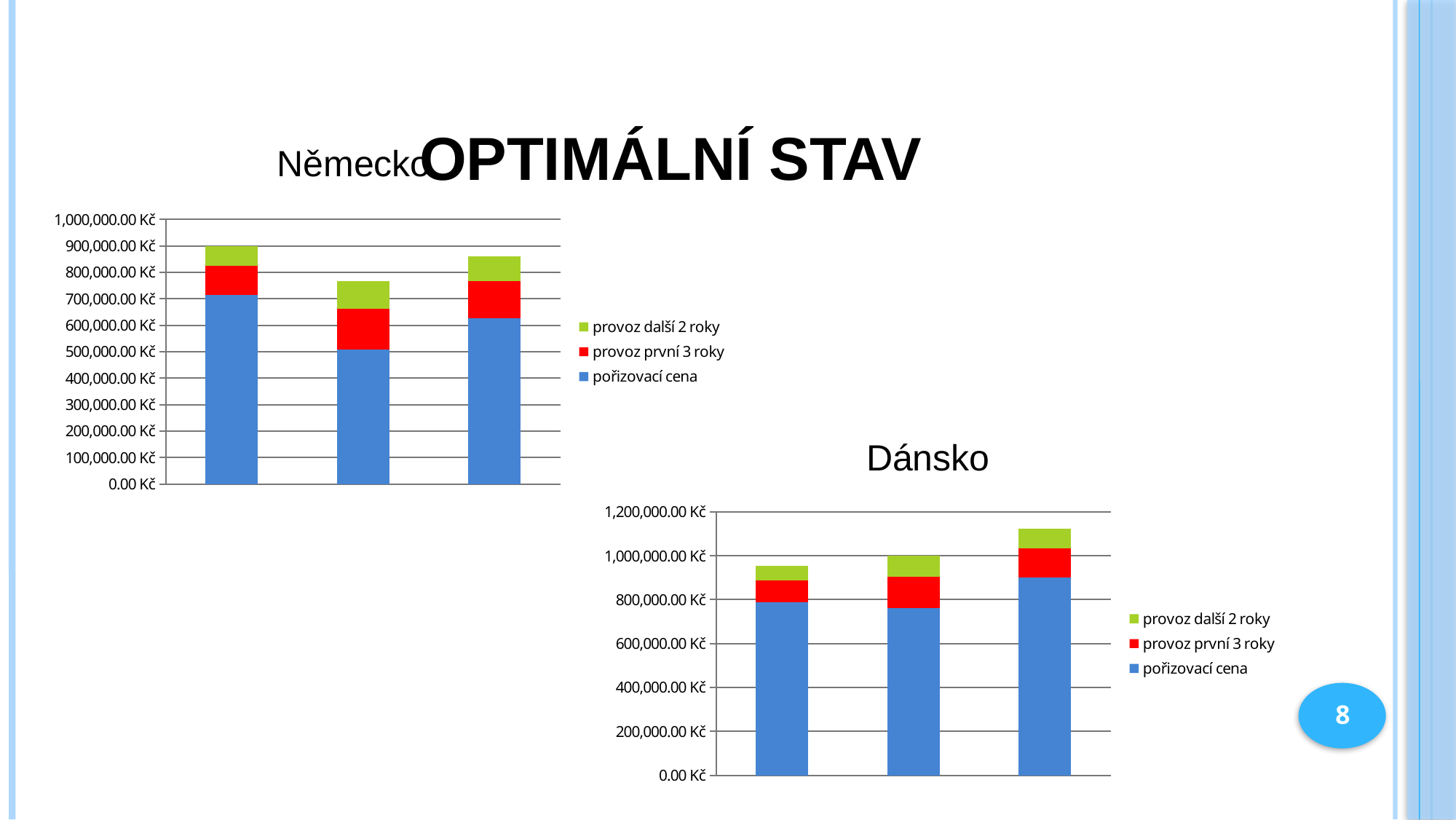
In the Dánsko chart, is the pořizovací cena segment of the rightmost bar greater or less than 800,000.00 Kč? greater In the Německo chart, is the total of the leftmost bar greater or less than 800,000.00 Kč? greater In the Dánsko chart, which bar is the tallest overall: the leftmost, middle or rightmost? rightmost In the Dánsko chart, is the total of the rightmost bar greater or less than 1,000,000.00 Kč? greater Which series is shown in blue in the Dánsko chart? pořizovací cena How many bars are plotted in the Německo chart? 3 In the Německo chart, which bar has the larger total: the leftmost or the middle bar? leftmost How many series does the legend of the Dánsko chart list? 3 In the Německo chart, which bar is the shortest overall: the leftmost, middle or rightmost? middle What kind of chart is the Německo chart? stacked bar chart